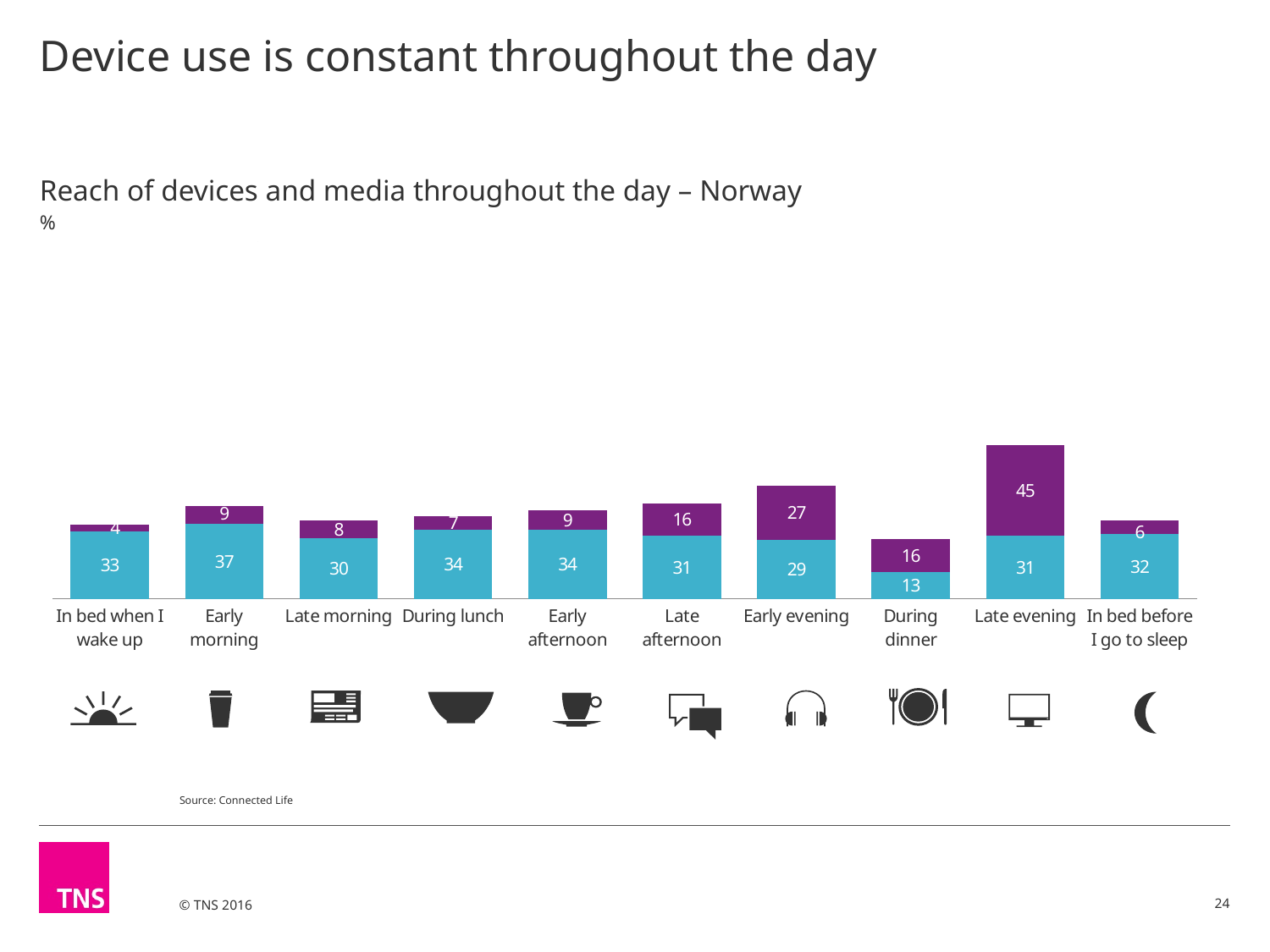
What is the value of the blue segment for Early morning? 37 How many time-of-day categories are shown on the x axis? 10 Which category has the lowest blue segment value? During dinner Which is larger, the blue segment for Late morning or the blue segment for During lunch? During lunch Which category has the highest purple segment value? Late evening What is the value of the blue segment for During dinner? 13 What is the difference between the purple segment values for Early evening and Late afternoon? 11 What type of chart is shown on the slide? stacked bar chart What is the total of the stacked bar for During dinner? 29 What is the value of the purple segment for Late evening? 45 What is the subtitle of the chart? Reach of devices and media throughout the day – Norway What is the total of the stacked bar for Late evening? 76